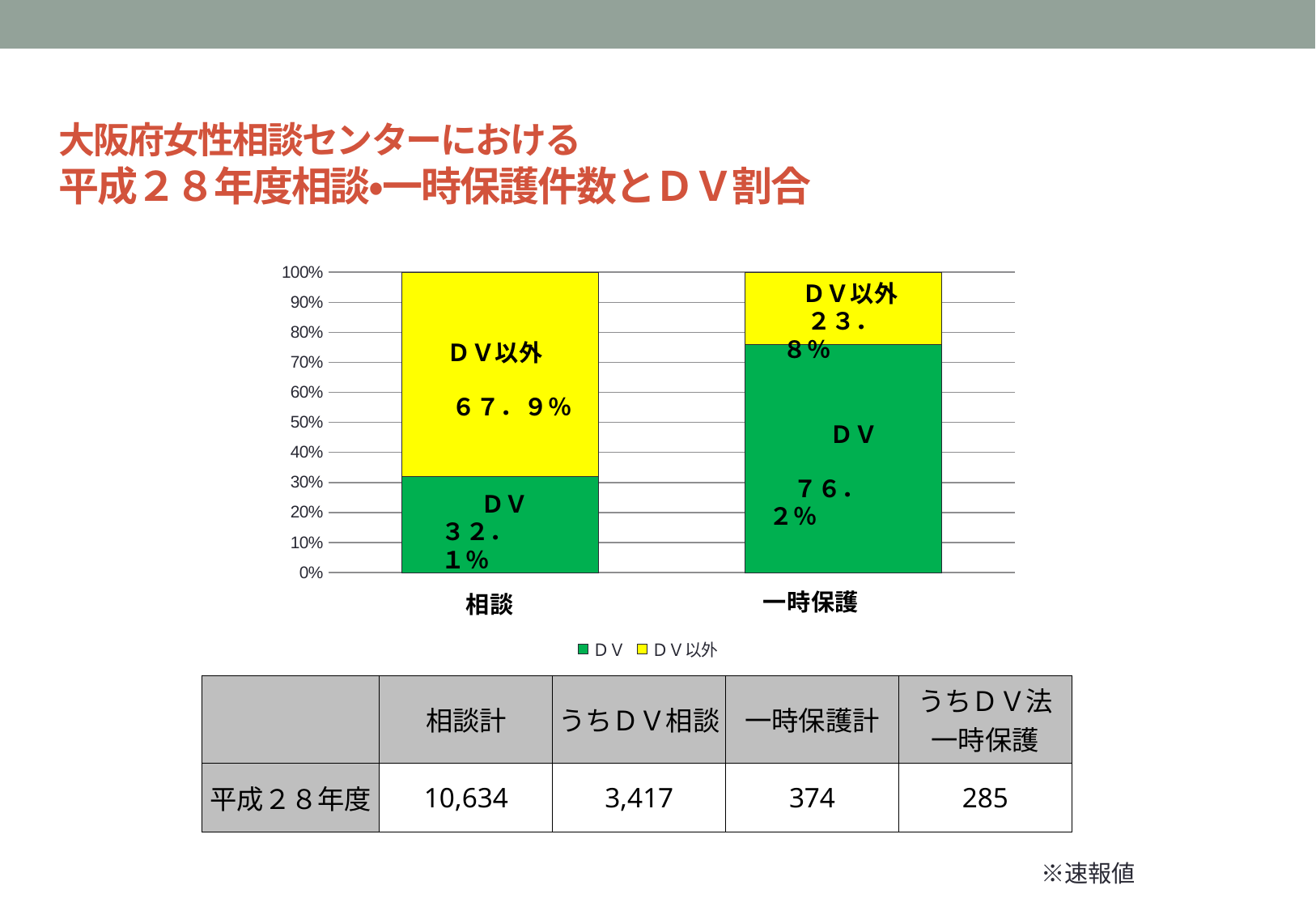
What is the DV以外 share shown for the 一時保護 bar? 23.8% Which category has the larger DV share, 相談 or 一時保護? 一時保護 What is the DV以外 share shown for the 相談 bar? 67.9% By how many percentage points does the DV share for 一時保護 exceed the DV share for 相談? 44.1 percentage points How many series does the chart legend list? 2 Which series is shown in green in the chart? DV How many categories are shown on the x axis of the chart? 2 What is the DV share shown for the 一時保護 bar? 76.2% Which category has the highest DV以外 share? 相談 What kind of chart is shown on the slide? Stacked bar chart What is the DV share shown for the 相談 bar? 32.1% Is the DV share for 相談 greater or less than 50%? less